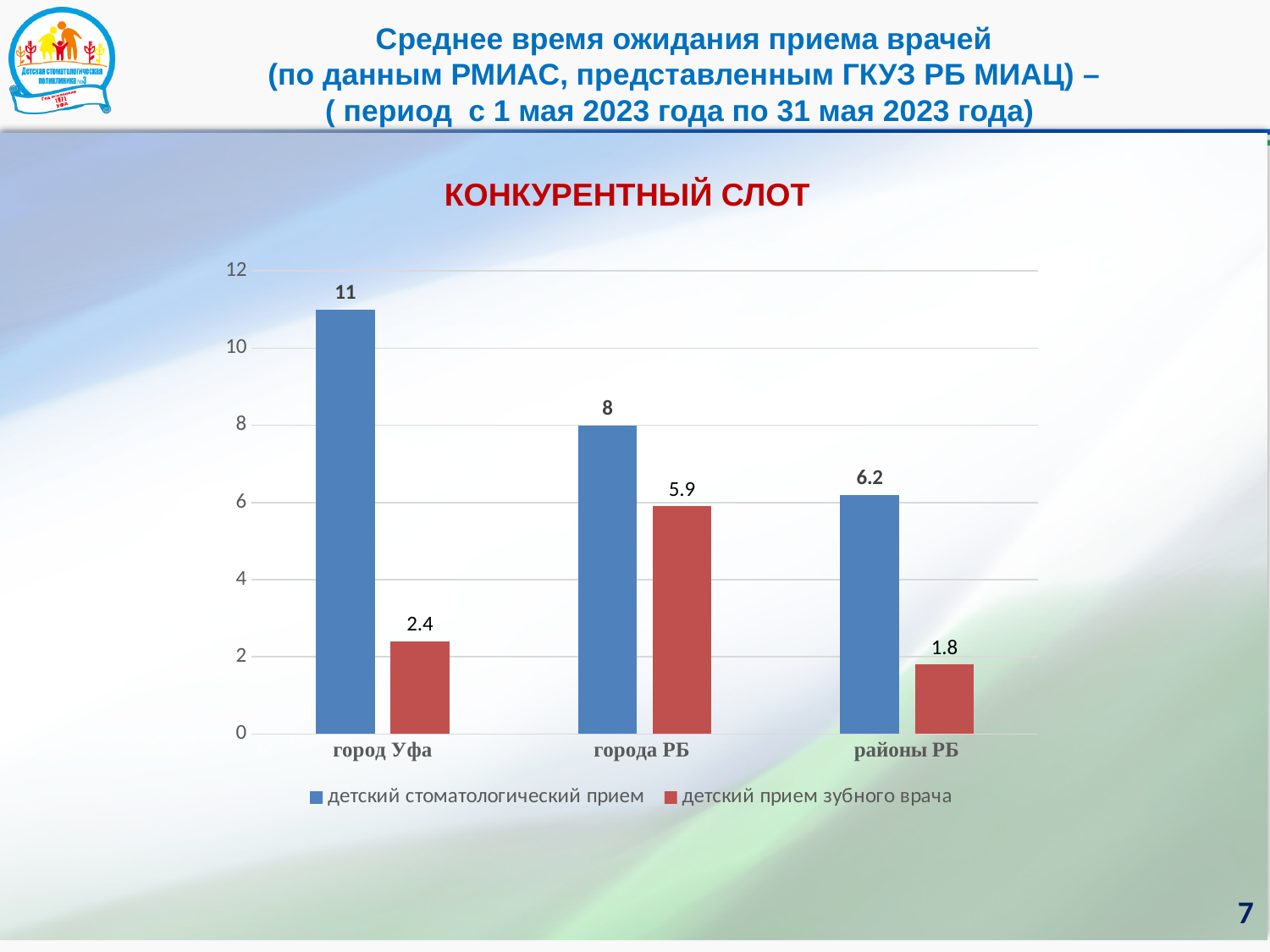
What is the title shown above the chart? КОНКУРЕНТНЫЙ СЛОТ How many categories are shown on the x axis? 3 Which is larger in города РБ: детский стоматологический прием or детский прием зубного врача? детский стоматологический прием What kind of chart is shown on the slide? bar chart Is the value for детский стоматологический прием in районы РБ greater or less than 6? greater What is the value for детский стоматологический прием in город Уфа? 11 What is the difference between детский стоматологический прием and детский прием зубного врача in город Уфа? 8.6 Which category has the lowest value for детский прием зубного врача? районы РБ How many series does the legend list? 2 What is the value for детский прием зубного врача in города РБ? 5.9 What is the value for детский прием зубного врача in районы РБ? 1.8 Which category has the highest value for детский стоматологический прием? город Уфа